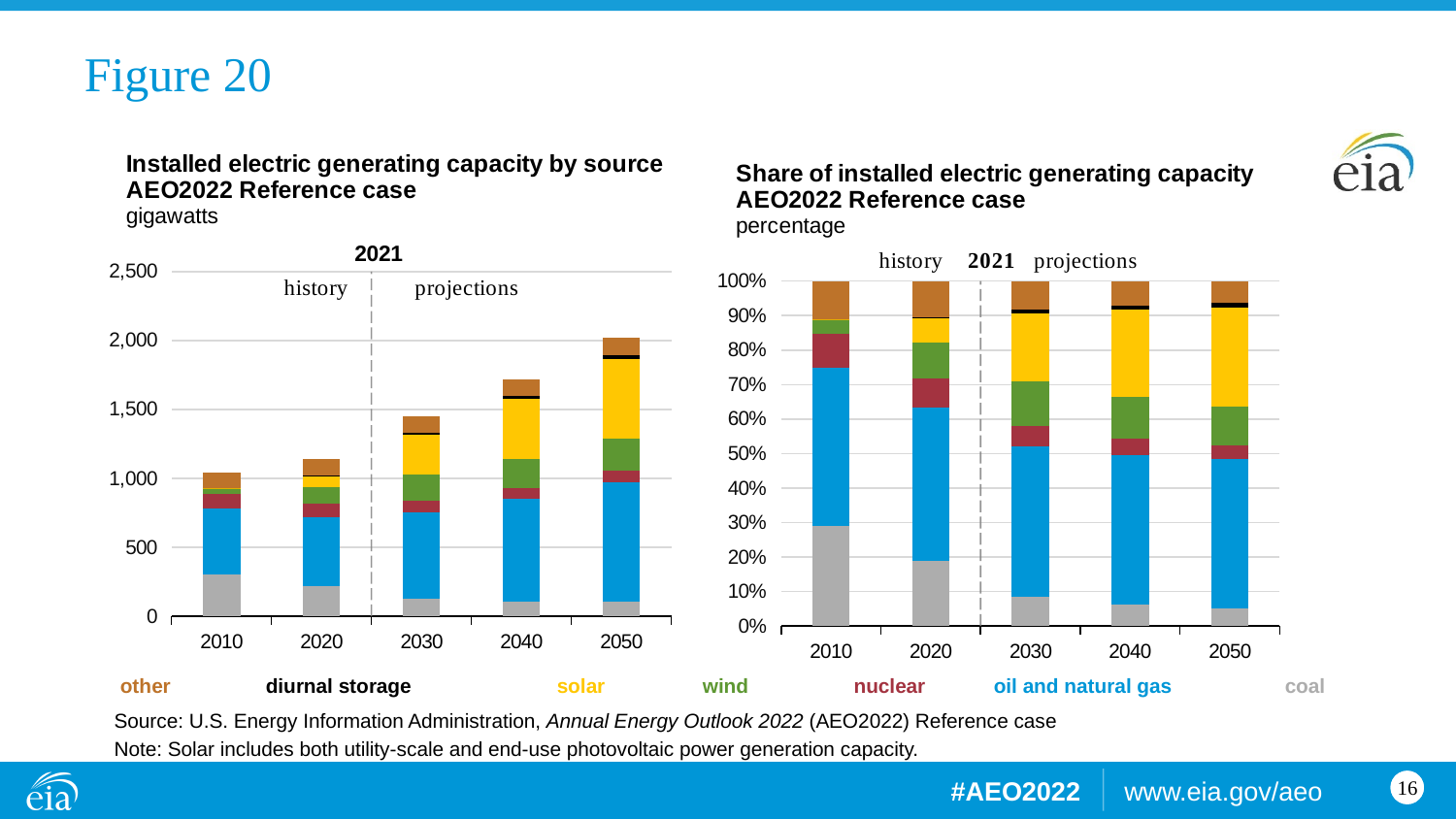
In the 'Share of installed electric generating capacity' chart, does the coal share rise or fall from 2010 to 2050? fall What unit is the 'Installed electric generating capacity by source' chart measured in? gigawatts In the 'Share of installed electric generating capacity' chart, which is larger: the solar share in 2010 or the solar share in 2050? 2050 How many years are shown on the x axis of the 'Share of installed electric generating capacity' chart on the right? 5 In the 'Installed electric generating capacity by source' chart, which year has the lowest total installed capacity? 2010 In the 'Installed electric generating capacity by source' chart, does total installed capacity rise or fall from 2010 to 2050? rise In the 'Installed electric generating capacity by source' chart, is the total capacity for 2010 greater or less than 1,500 gigawatts? less In the 'Installed electric generating capacity by source' chart, which year has the highest total installed capacity? 2050 In the 'Installed electric generating capacity by source' chart, is the total capacity for 2040 greater or less than 1,500 gigawatts? greater In the 'Share of installed electric generating capacity' chart, is the coal share in 2050 greater or less than 10%? less What kind of chart is the 'Installed electric generating capacity by source' chart on the left? stacked bar chart How many sources does the legend below the charts list? 7